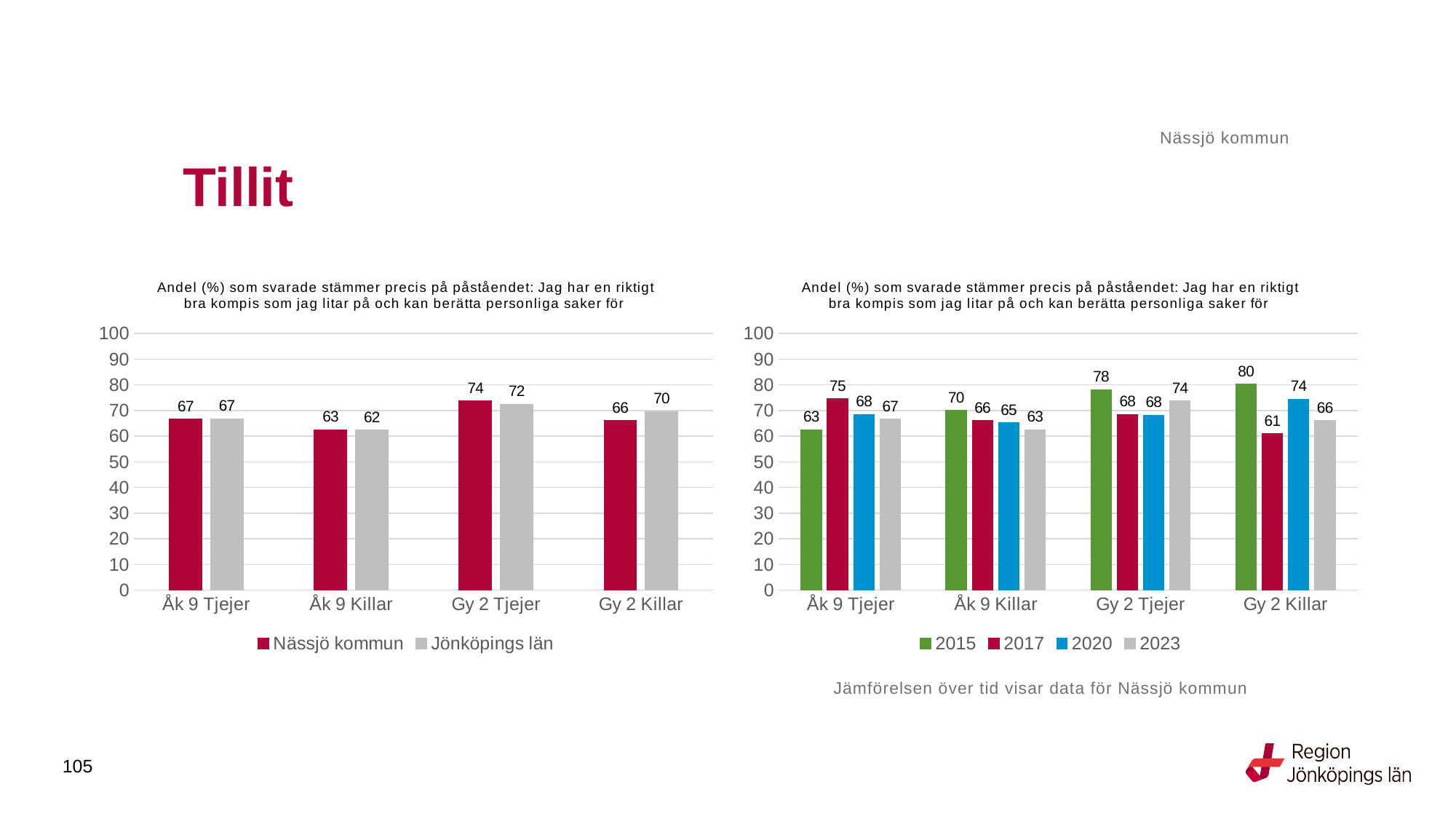
In the left chart, which category has the lowest value for Jönköpings län? Åk 9 Killar In the right chart, what is the value for 2015 for Gy 2 Killar? 80 In the left chart, what is the value for Nässjö kommun for Gy 2 Tjejer? 74 In the right chart, how many series does the legend list? 4 In the right chart, which year has the highest value for Åk 9 Tjejer? 2017 In the right chart, is the value for 2020 for Gy 2 Tjejer larger or the value for 2023 for Gy 2 Tjejer? 2023 In the left chart, what is the difference between Nässjö kommun and Jönköpings län for Gy 2 Killar? 4 In the left chart, what is the value for Jönköpings län for Gy 2 Killar? 70 What kind of chart is the right chart? Bar chart In the left chart, how many series does the legend list? 2 In the right chart, which year has the lowest value for Gy 2 Killar? 2017 In the right chart, what is the value for 2023 for Åk 9 Killar? 63